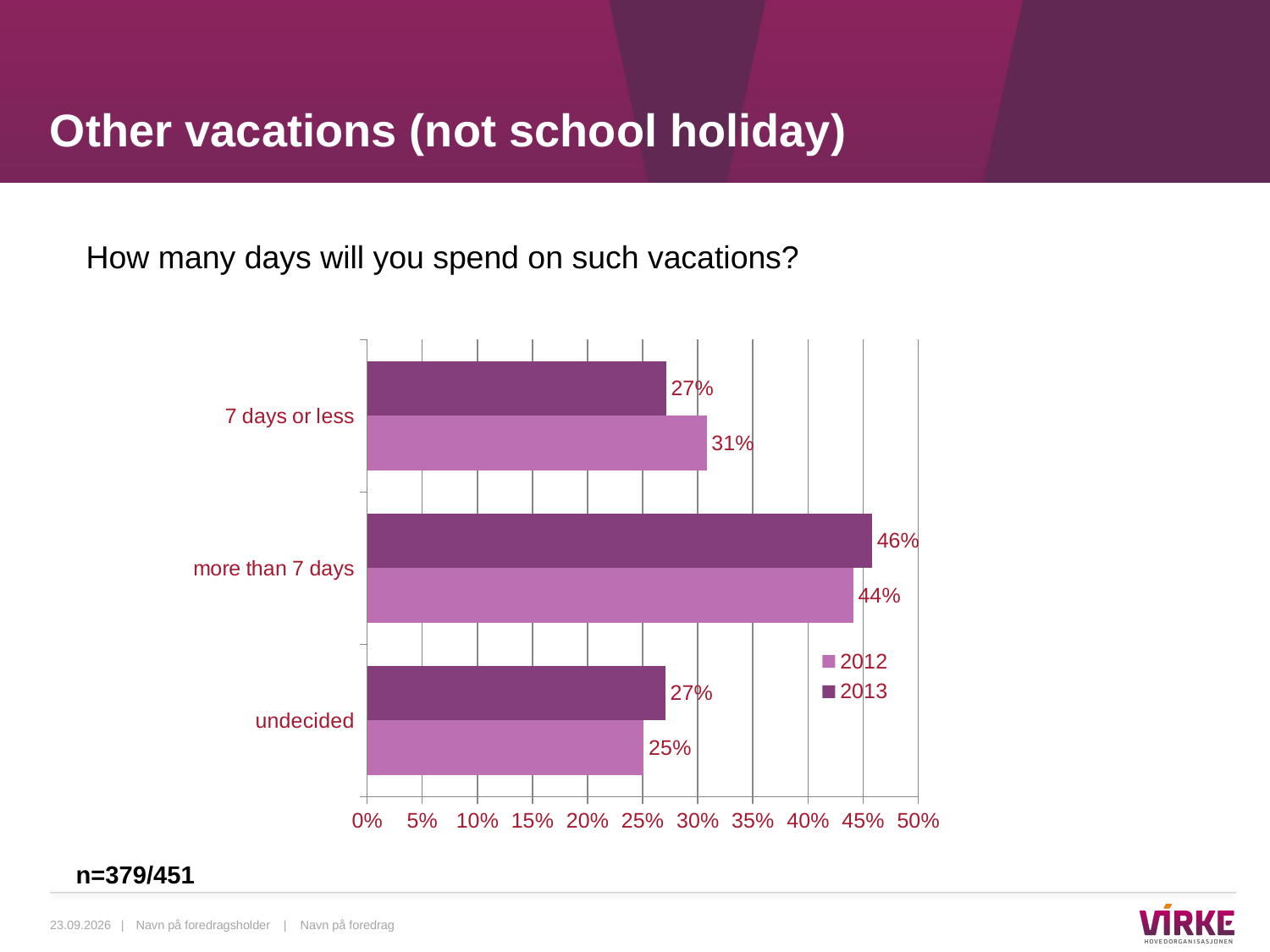
How many series does the legend list? 2 For 'undecided', which year has the larger value, 2012 or 2013? 2013 Which category has the lowest 2012 value? undecided Which category has the highest 2012 value? more than 7 days What kind of chart is shown on the slide? bar chart What is the 2012 value for 'undecided'? 25% What is the 2013 value for 'more than 7 days'? 46% What is the 2012 value for '7 days or less'? 31% What is the 2013 value for '7 days or less'? 27% What is the difference between the 2012 and 2013 values for '7 days or less'? 4% What is the difference between the 2013 and 2012 values for 'more than 7 days'? 2% How many categories are shown on the chart? 3